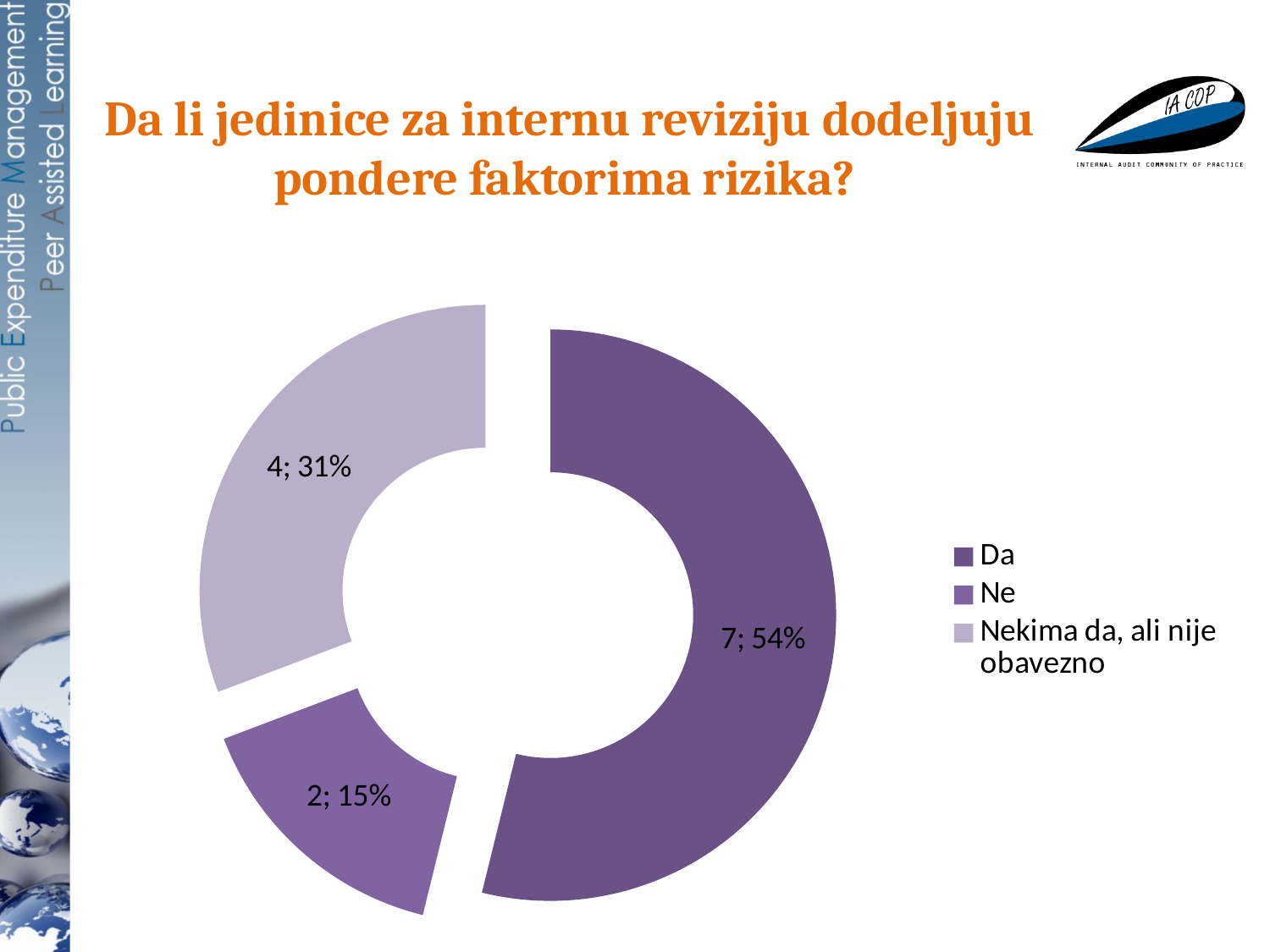
What is the title of the chart on the slide? Da li jedinice za internu reviziju dodeljuju pondere faktorima rizika? What percentage share does the 'Da' category have? 54% What is the total count across all three categories? 13 What is the count for the 'Da' category? 7 What percentage share does the 'Ne' category have? 15% What is the count for the 'Nekima da, ali nije obavezno' category? 4 Which category has the smallest share? Ne What kind of chart is shown on the slide? doughnut chart How many categories does the chart show? 3 Which category has the largest share? Da What is the difference in count between 'Da' and 'Ne'? 5 Which is larger, the count for 'Nekima da, ali nije obavezno' or the count for 'Ne'? Nekima da, ali nije obavezno